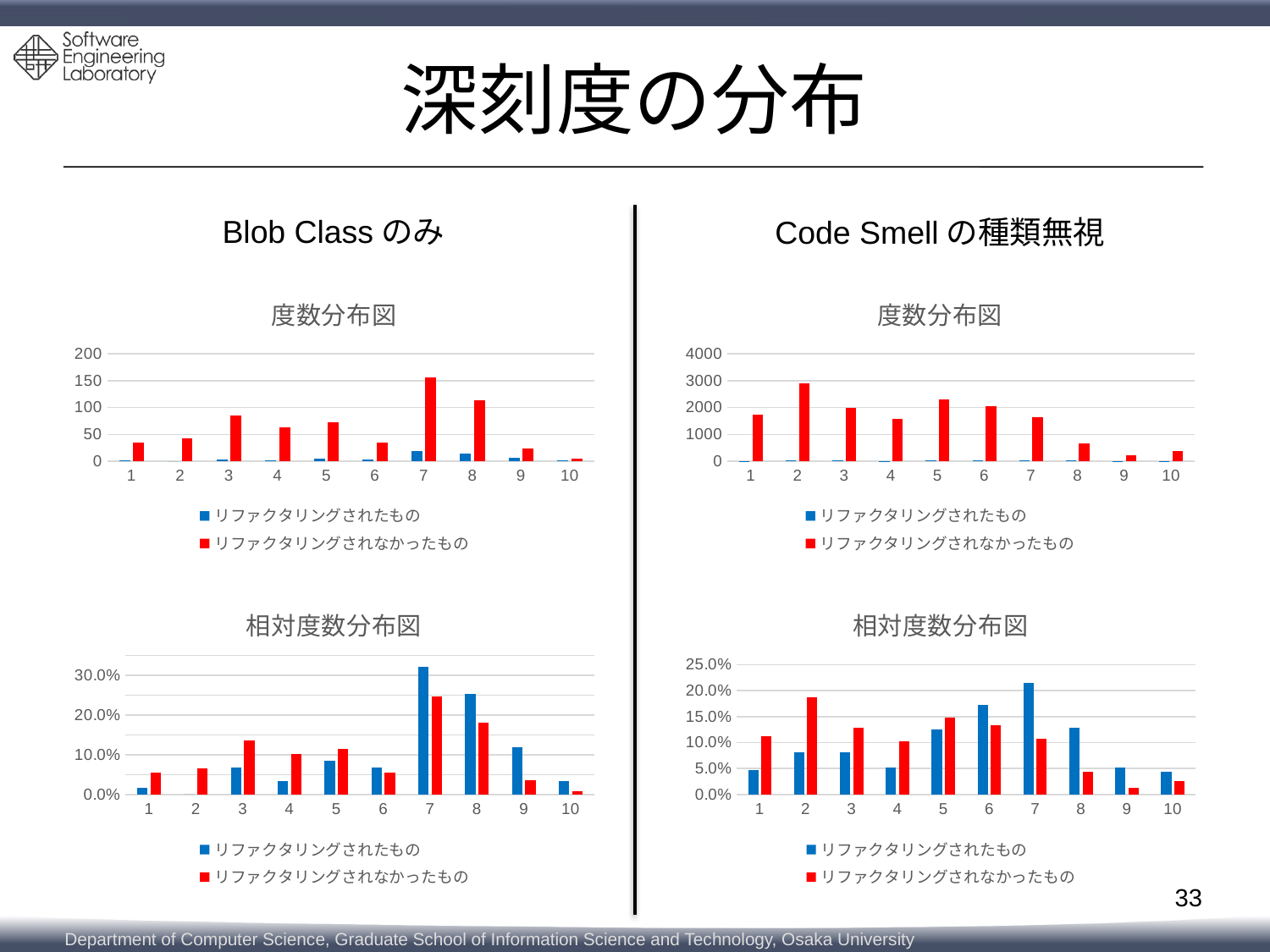
In the top-left chart (Blob Class のみ, 度数分布図), is the value for リファクタリングされなかったもの at category 7 greater or less than 150? greater In the top-right chart (Code Smell の種類無視, 度数分布図), which category has the lowest value for リファクタリングされなかったもの? 9 In the bottom-right chart (Code Smell の種類無視, 相対度数分布図), which category has the highest value for リファクタリングされたもの? 7 In the bottom-left chart (Blob Class のみ, 相対度数分布図), which category has the highest value for リファクタリングされたもの? 7 In the top-left chart (Blob Class のみ, 度数分布図), how many severity categories are shown on the x axis? 10 In the bottom-left chart (Blob Class のみ, 相対度数分布図), is the value for リファクタリングされたもの at category 7 greater or less than 30.0%? greater In the top-left chart (Blob Class のみ, 度数分布図), which severity category has the highest value for リファクタリングされなかったもの? 7 In the top-right chart (Code Smell の種類無視, 度数分布図), is the value for リファクタリングされなかったもの at category 2 greater or less than 2000? greater In the top-left chart (Blob Class のみ, 度数分布図), how many series does the legend list? 2 In the bottom-right chart (Code Smell の種類無視, 相対度数分布図), at category 2, which series has the larger value: リファクタリングされたもの or リファクタリングされなかったもの? リファクタリングされなかったもの What kind of chart is the bottom-left chart (Blob Class のみ, 相対度数分布図)? bar chart